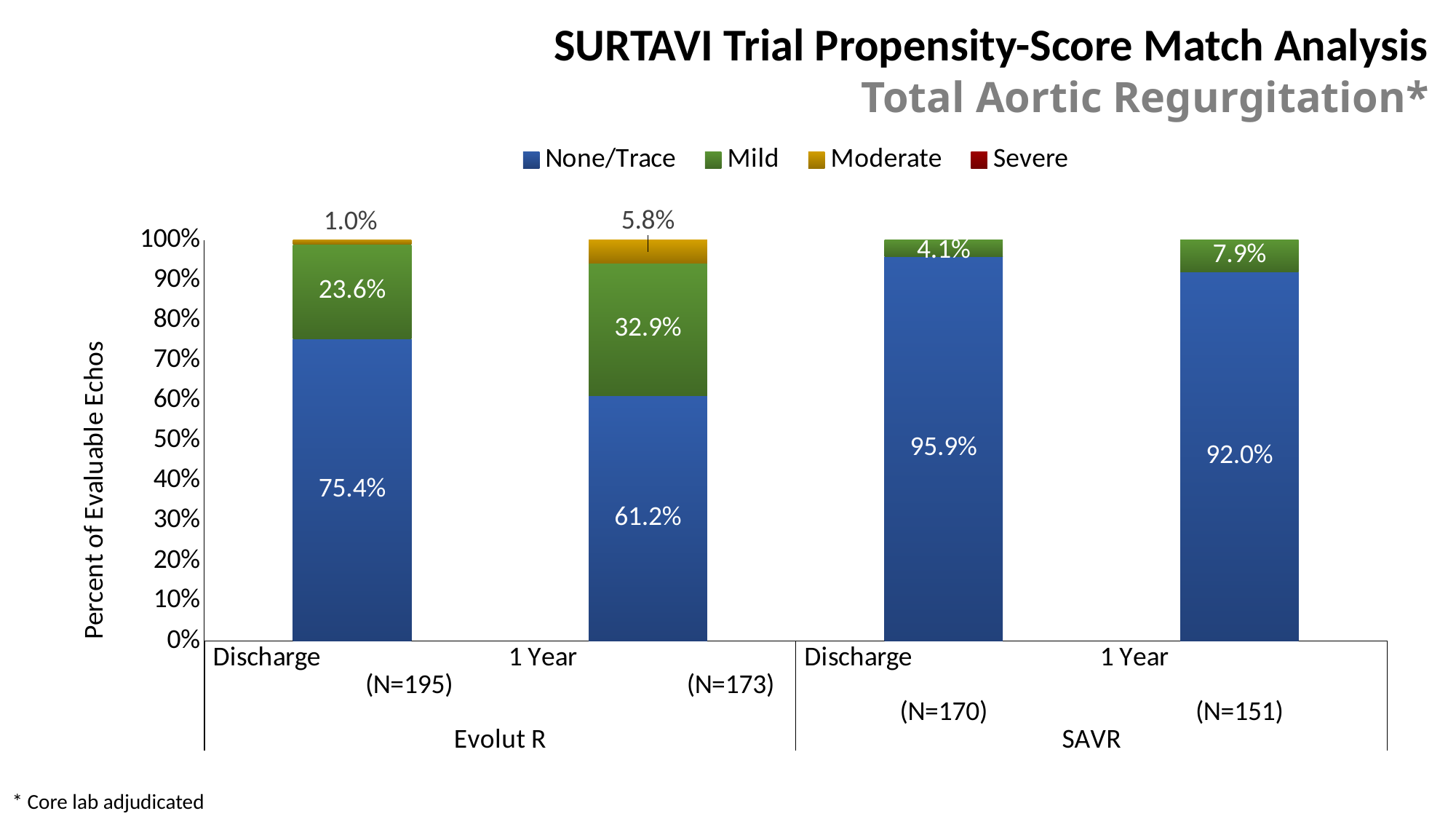
How many bars are plotted in the chart? 4 Which bar has the lowest None/Trace value? Evolut R 1 Year What is the difference between the None/Trace values for Evolut R at Discharge and at 1 Year? 14.2% What is the None/Trace value for SAVR at Discharge? 95.9% What is the Mild value for SAVR at 1 Year? 7.9% What is the None/Trace value for Evolut R at Discharge? 75.4% How many series does the legend list? 4 Which bar has the highest None/Trace value? SAVR Discharge Is the Mild value larger for Evolut R at Discharge or for SAVR at Discharge? Evolut R at Discharge What is the Moderate value for Evolut R at 1 Year? 5.8% What kind of chart is shown on the slide? stacked bar chart What is the Mild value for Evolut R at 1 Year? 32.9%